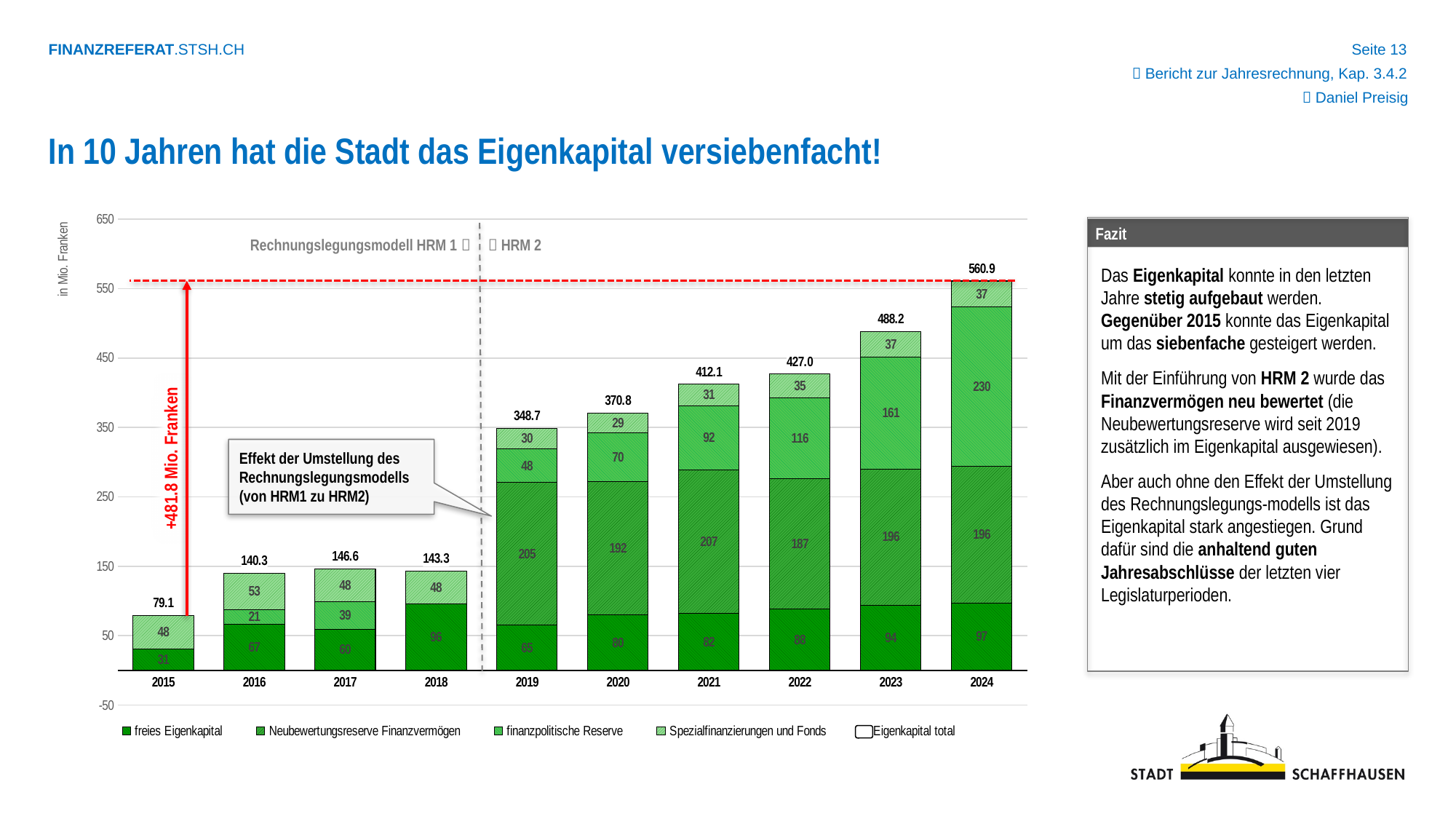
What kind of chart is shown on the slide? Stacked bar chart How many entries does the chart legend list? 5 What is the Eigenkapital total shown for 2024? 560.9 What is the Eigenkapital total shown for 2015? 79.1 Do the Eigenkapital totals generally rise or fall from 2015 to 2024? Rise Which year has the lowest Eigenkapital total? 2015 What unit is given on the y axis of the chart? in Mio. Franken What is the value of freies Eigenkapital (bottom segment) in 2024? 97 By how much did the Eigenkapital total increase from 2015 to 2024? 481.8 Which year has the larger Eigenkapital total, 2017 or 2018? 2017 How many years are shown on the x axis of the chart? 10 Which year has the highest Eigenkapital total? 2024